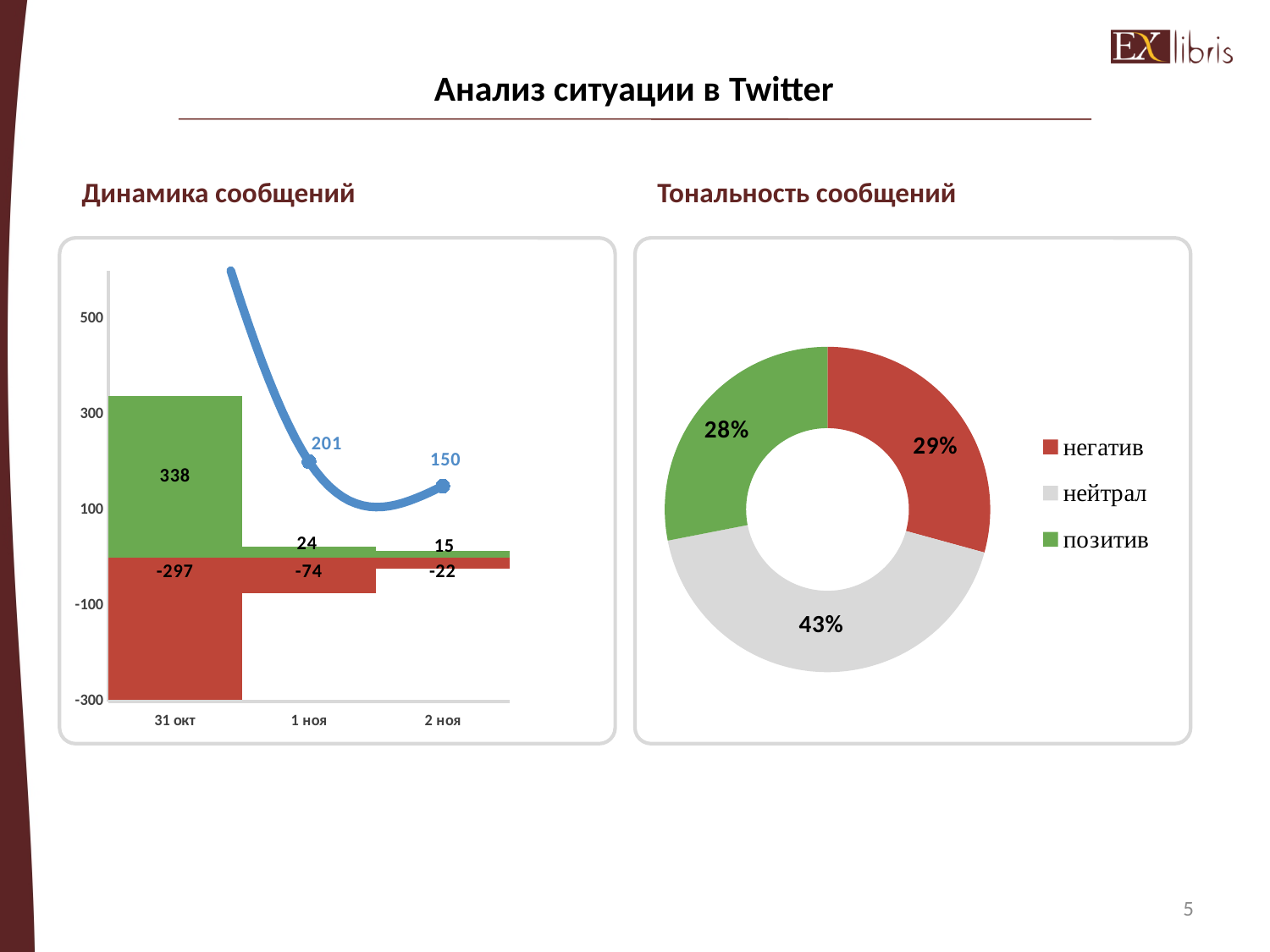
In the "Тональность сообщений" chart, which category has the largest share? нейтрал In the "Тональность сообщений" chart, what colour represents негатив? red In the "Динамика сообщений" chart, what is the value of the green bar for 31 окт? 338 In the "Динамика сообщений" chart, what is the difference between the blue line values at 1 ноя and 2 ноя? 51 In the "Динамика сообщений" chart, which date has the smallest green bar? 2 ноя In the "Тональность сообщений" chart, what share is нейтрал? 43% In the "Тональность сообщений" chart, how many entries does the legend list? 3 In the "Динамика сообщений" chart, what is the value of the red bar for 1 ноя? -74 In the "Динамика сообщений" chart, what value does the blue line show at 2 ноя? 150 In the "Динамика сообщений" chart, how many dates are shown on the x axis? 3 In the "Динамика сообщений" chart, which date has the highest green bar? 31 окт In the "Динамика сообщений" chart, do the green bar values rise or fall from 31 окт to 2 ноя? fall